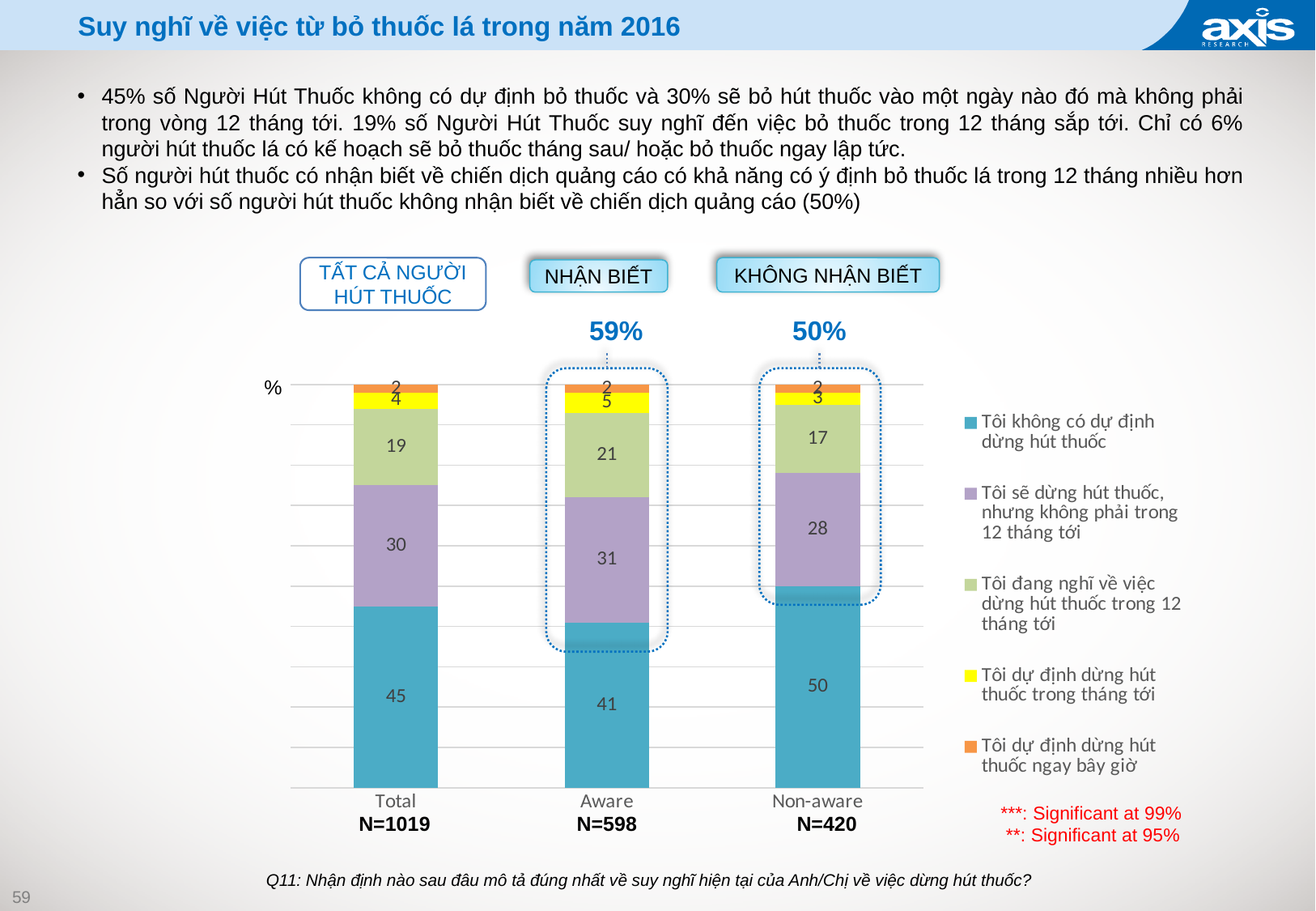
Which is larger: the "Tôi sẽ dừng hút thuốc, nhưng không phải trong 12 tháng tới" value for Total or for Non-aware? Total What is the value for "Tôi đang nghĩ về việc dừng hút thuốc trong 12 tháng tới" in the Non-aware bar? 17 Which category has the lowest value for "Tôi đang nghĩ về việc dừng hút thuốc trong 12 tháng tới"? Non-aware What kind of chart is shown on the slide? Stacked bar chart What is the value for "Tôi dự định dừng hút thuốc trong tháng tới" in the Aware bar? 5 What is the value for "Tôi sẽ dừng hút thuốc, nhưng không phải trong 12 tháng tới" in the Aware bar? 31 Which category has the highest value for "Tôi không có dự định dừng hút thuốc"? Non-aware What is the value for "Tôi không có dự định dừng hút thuốc" in the Total bar? 45 What is the sample size (N) shown for the Aware category? N=598 What is the difference between the Non-aware and Aware values for "Tôi không có dự định dừng hút thuốc"? 9 How many series does the chart legend list? 5 How many categories are shown on the x axis of the chart? 3